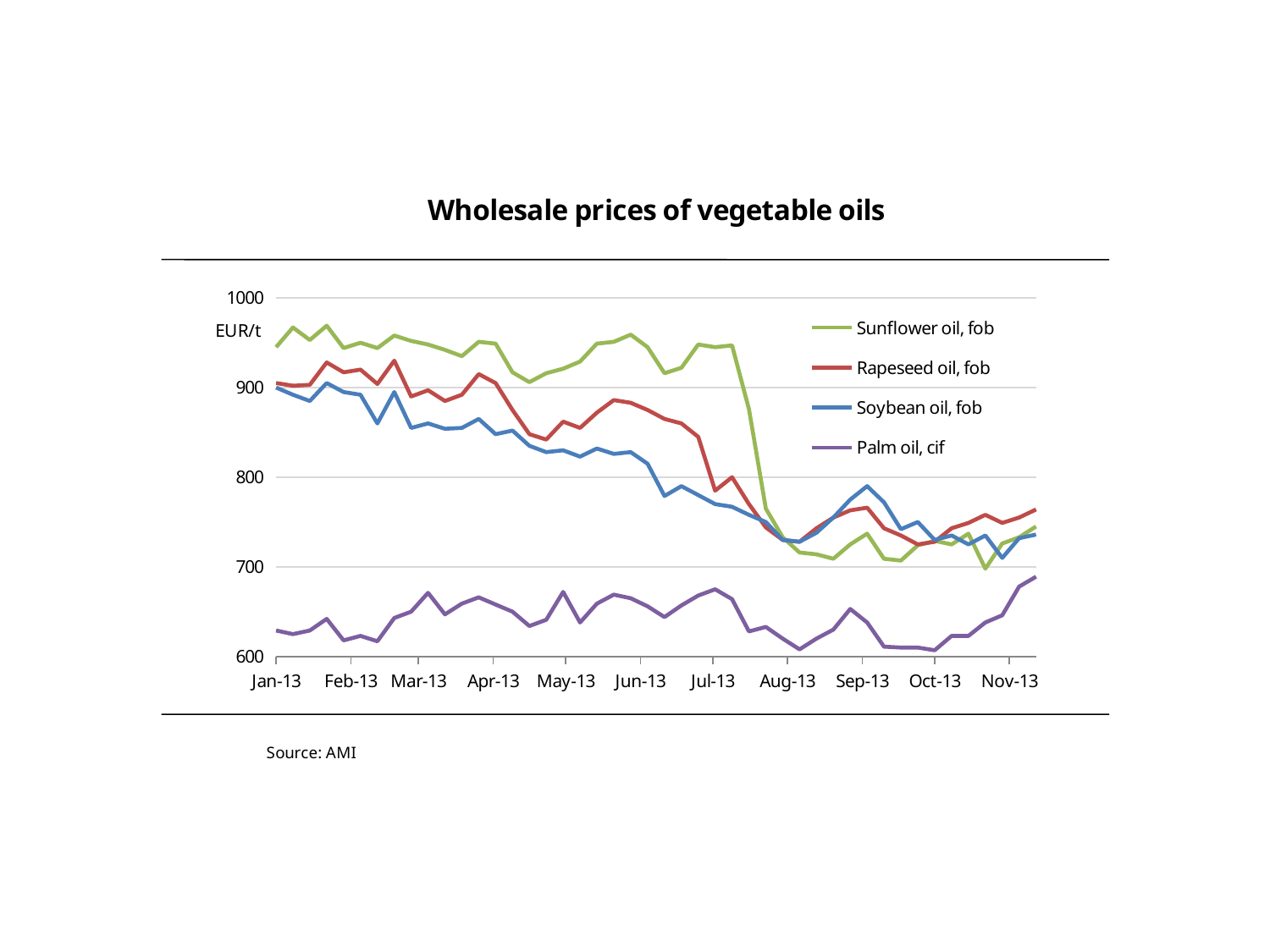
At Jan-13, which is higher: Sunflower oil, fob or Palm oil, cif? Sunflower oil, fob Is the value for Sunflower oil, fob at Jan-13 greater or less than 900? greater At Jun-13, which is higher: Rapeseed oil, fob or Soybean oil, fob? Rapeseed oil, fob What kind of chart is shown on the slide? line chart What unit is shown on the vertical axis of the chart? EUR/t Which series has the lowest values across the whole period? Palm oil, cif Does the Sunflower oil, fob line rise or fall from Jan-13 to Nov-13? fall What is the title of the chart? Wholesale prices of vegetable oils How many series does the legend list? 4 Is the value for Palm oil, cif at Jan-13 greater or less than 700? less Is the value for Rapeseed oil, fob at Aug-13 greater or less than 800? less Does the Palm oil, cif line rise or fall from Oct-13 to Nov-13? rise